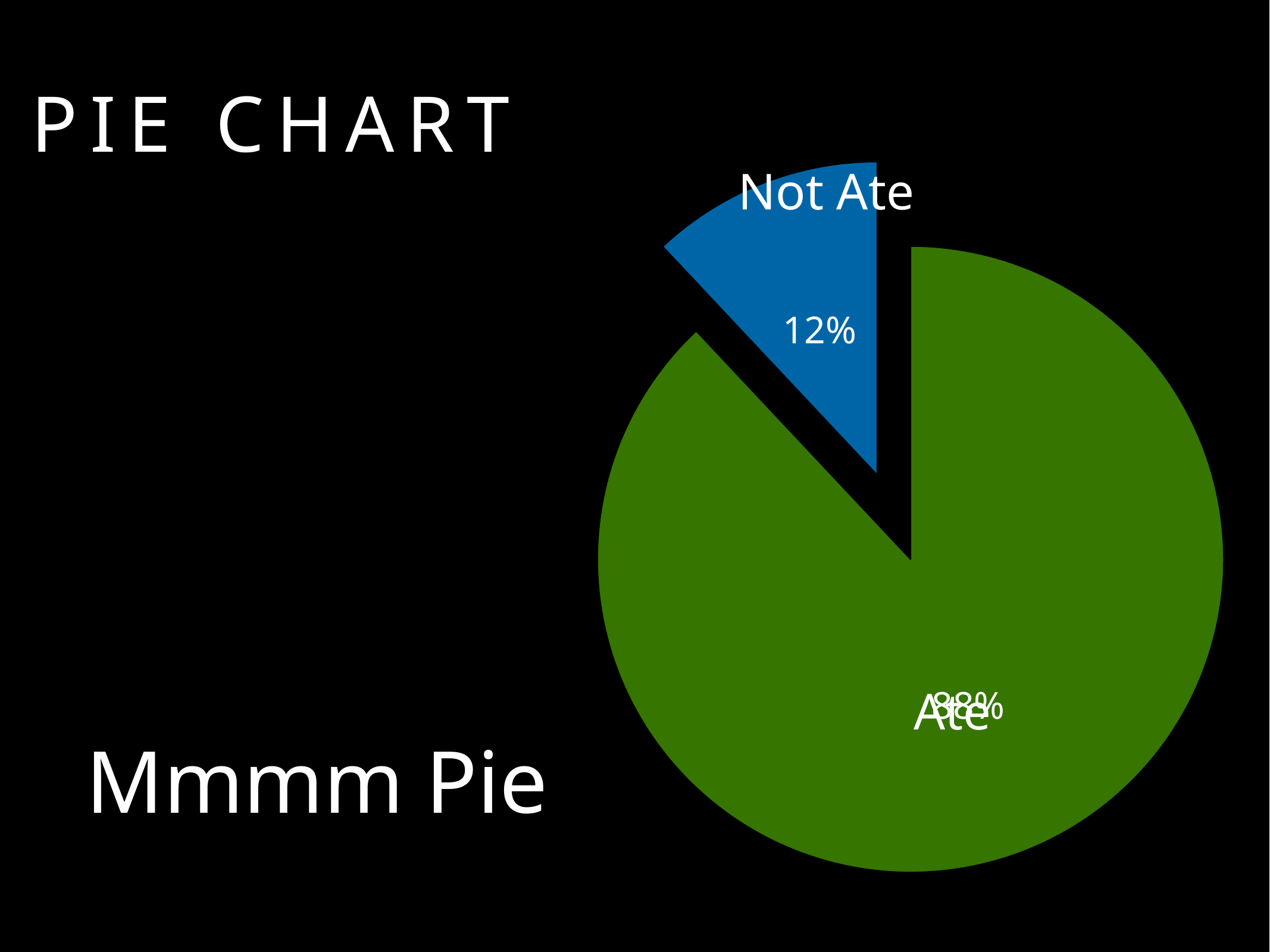
What colour is the "Not Ate" slice? blue Which slice is larger, "Ate" or "Not Ate"? Ate What percentage of the pie is labelled "Not Ate"? 12% What colour is the "Ate" slice? green What percentage of the pie is labelled "Ate"? 88% Which slice of the pie chart is the largest? Ate What is the difference in percentage points between the "Ate" and "Not Ate" slices? 76% What kind of chart is shown on the slide? pie chart How many slices does the pie chart have? 2 Which slice of the pie chart is the smallest? Not Ate Is the share of the "Not Ate" slice greater or less than 50%? less